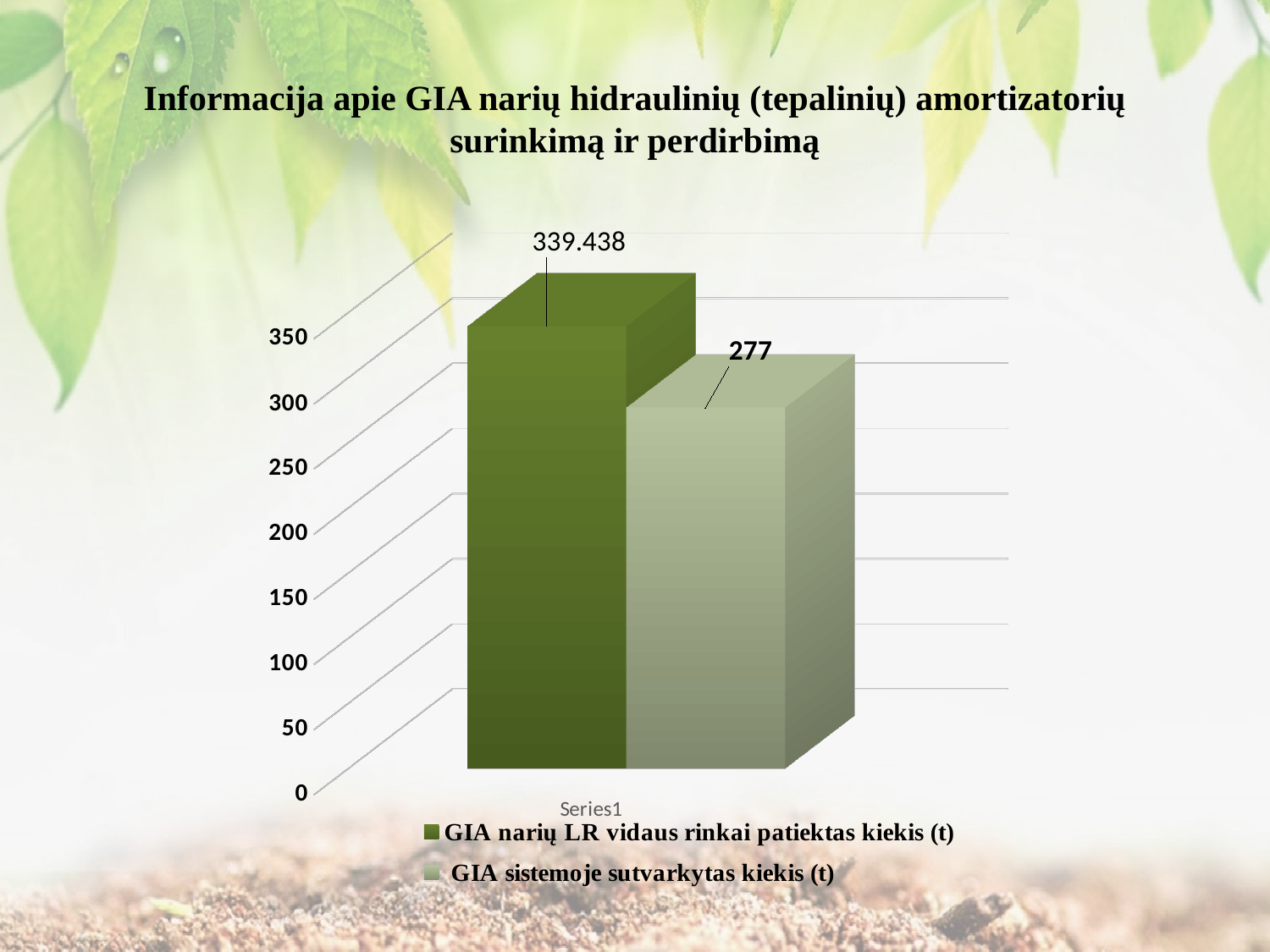
Is the value for 'GIA narių LR vidaus rinkai patiektas kiekis (t)' greater or less than 300? greater How many series does the legend list? 2 Which series has the higher value? GIA narių LR vidaus rinkai patiektas kiekis (t) What is the highest value shown on the vertical axis? 350 What is the difference between the value for 'GIA narių LR vidaus rinkai patiektas kiekis (t)' and the value for 'GIA sistemoje sutvarkytas kiekis (t)'? 62.438 What value is shown for 'GIA sistemoje sutvarkytas kiekis (t)'? 277 What is the category label shown under the bars? Series1 What value is shown for 'GIA narių LR vidaus rinkai patiektas kiekis (t)'? 339.438 Which series has the lower value? GIA sistemoje sutvarkytas kiekis (t) Is the value for 'GIA sistemoje sutvarkytas kiekis (t)' larger or smaller than the value for 'GIA narių LR vidaus rinkai patiektas kiekis (t)'? smaller Is the value for 'GIA sistemoje sutvarkytas kiekis (t)' greater or less than 300? less What kind of chart is shown on the slide? bar chart